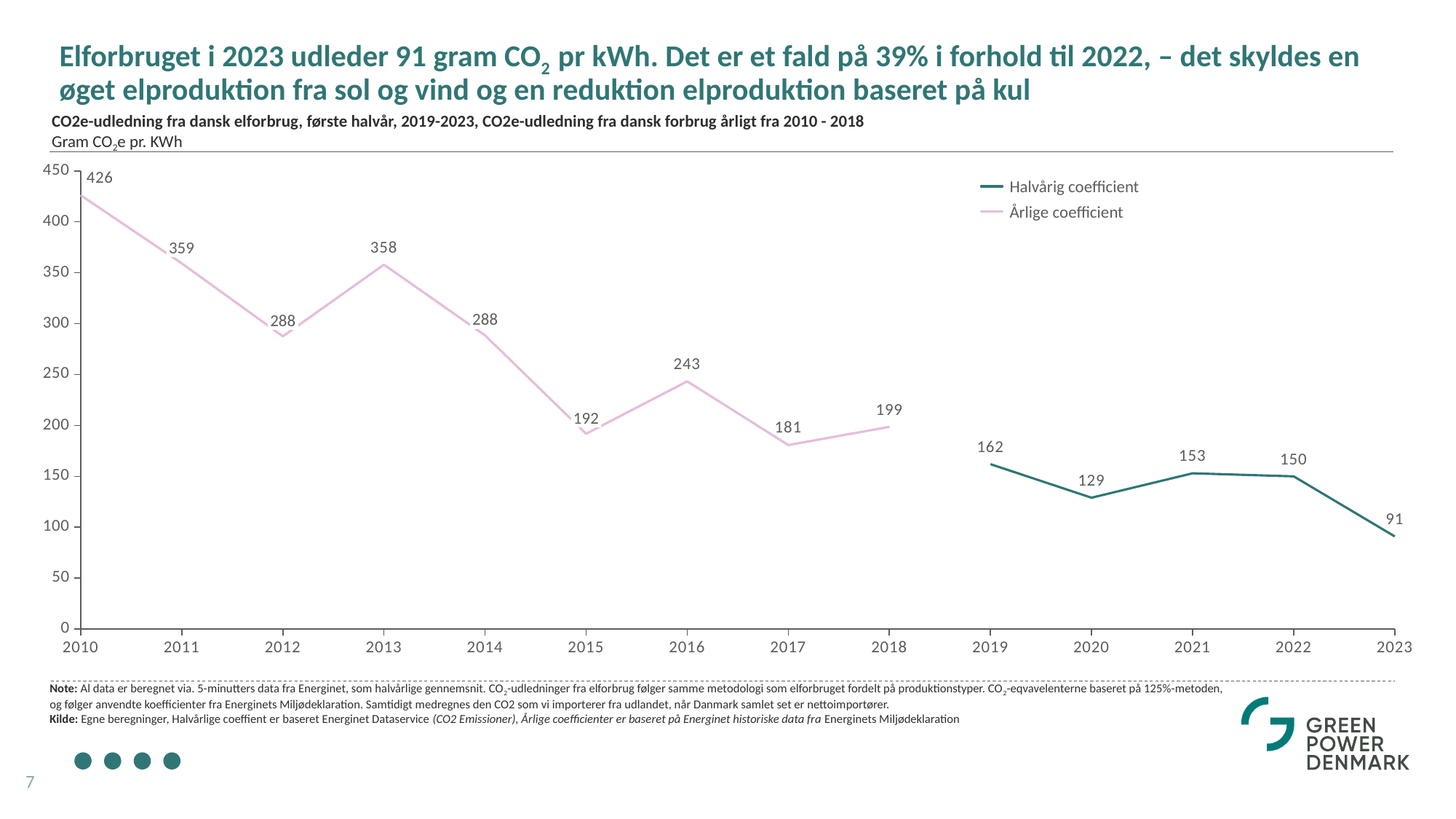
What is the difference between the values for 2022 and 2023? 59 Which is larger, the value for 2013 or the value for 2016? 2013 What kind of chart is shown on the slide? Line chart Do the values of the Halvårig coefficient series rise or fall from 2022 to 2023? Fall Which year has the lowest value on the chart? 2023 What is the unit shown on the y axis of the chart? Gram CO2e pr. KWh Which year has the highest value on the chart? 2010 What is the value for 2020 on the chart? 129 How many series does the legend list? 2 What is the value for 2010 on the chart? 426 How many years are shown on the x axis of the chart? 14 What is the value for 2023 on the chart? 91